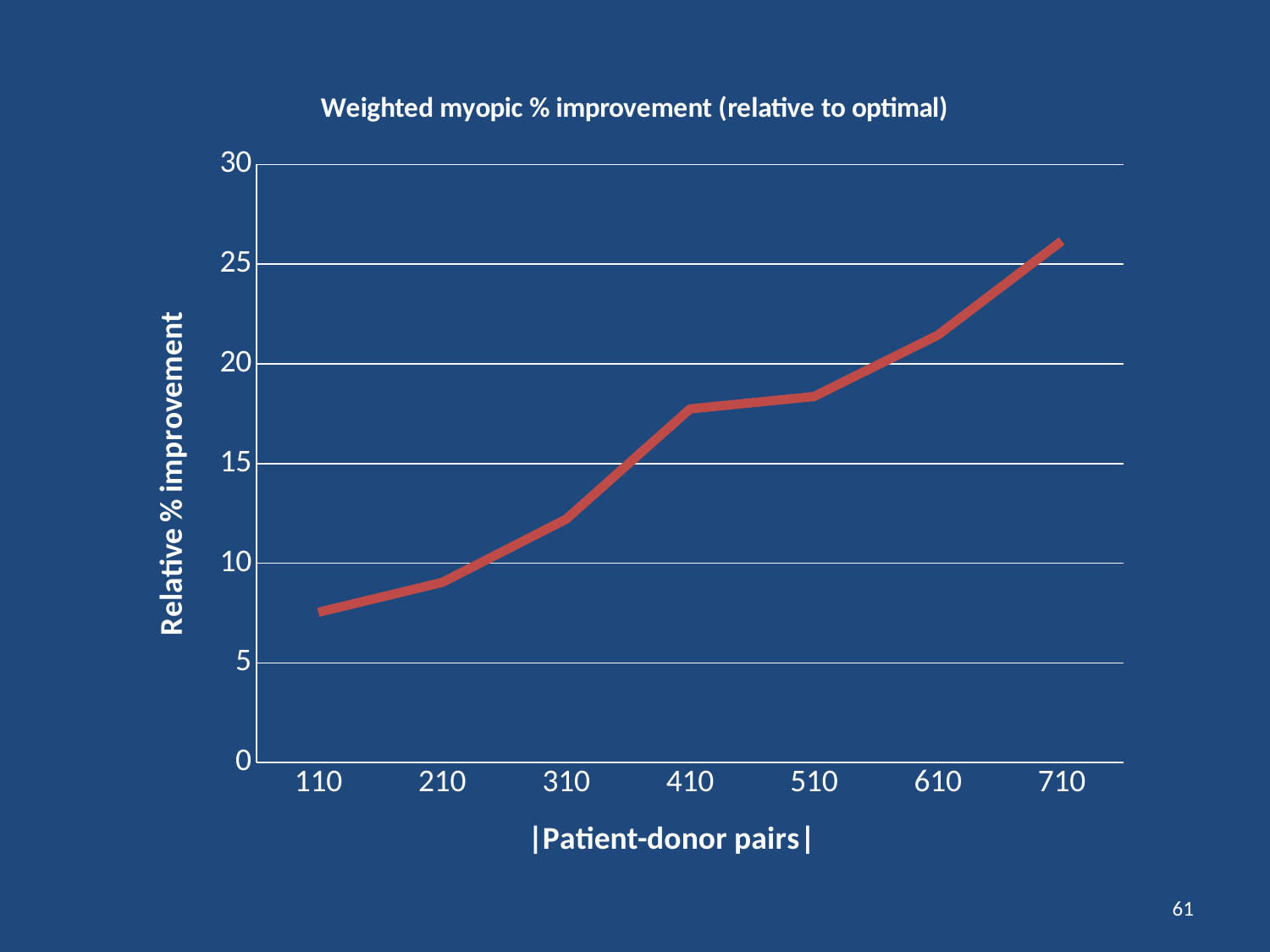
What is the label of the x axis? |Patient-donor pairs| Which has the larger relative % improvement, 310 or 510 patient-donor pairs? 510 What is the title of the chart? Weighted myopic % improvement (relative to optimal) Is the value for 710 patient-donor pairs greater or less than 25? greater Is the value for 610 patient-donor pairs greater or less than 20? greater What kind of chart is shown on the slide? line chart Is the value for 110 patient-donor pairs greater or less than 10? less How many data points are plotted on the line? 7 At which number of patient-donor pairs is the relative % improvement highest? 710 Do the values rise or fall as the number of patient-donor pairs increases along the x axis? rise At which number of patient-donor pairs is the relative % improvement lowest? 110